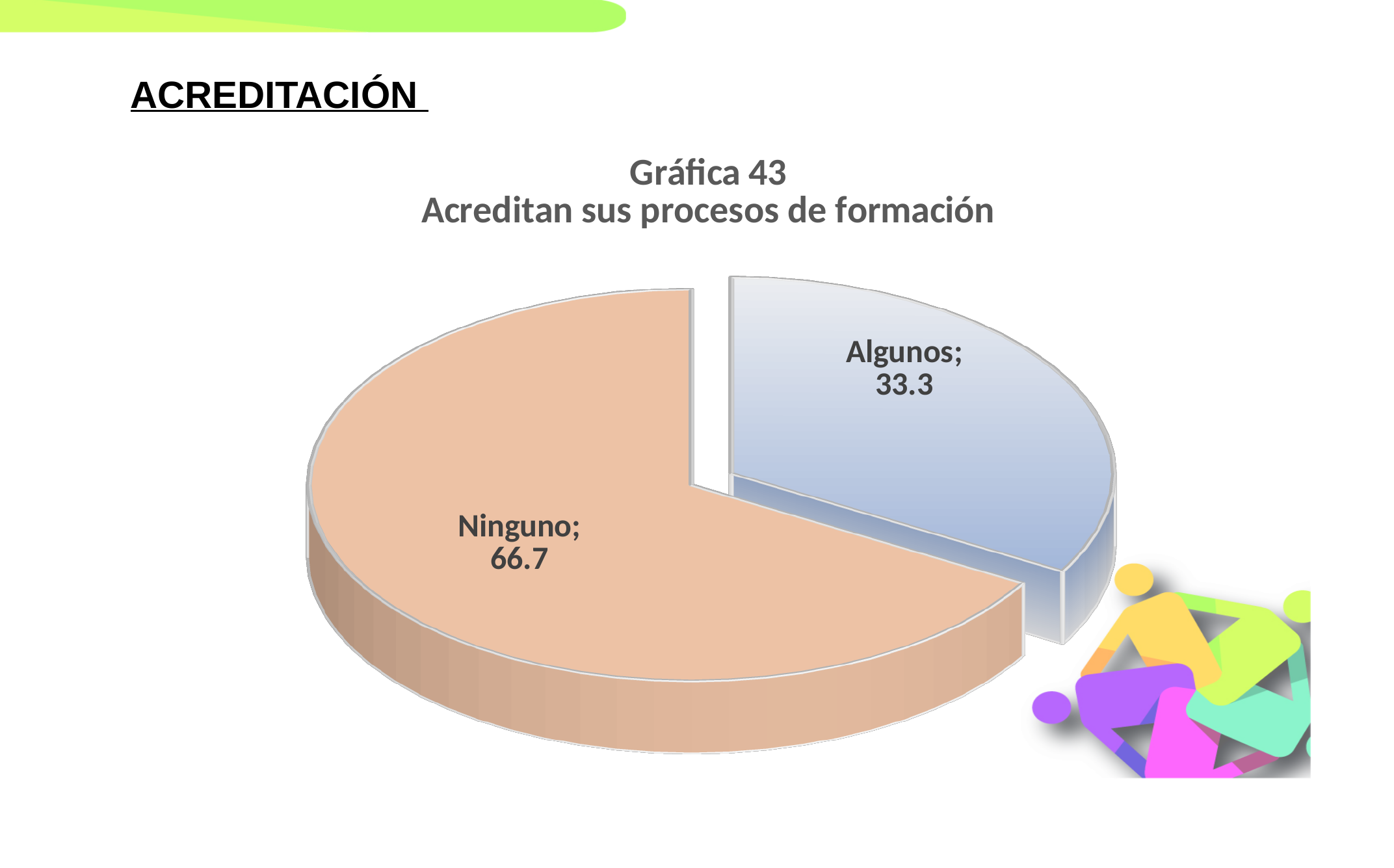
How many categories are shown in the pie chart? 2 What is the value for Ninguno? 66.7 What share of the pie does the Ninguno slice represent? 66.7 What is the value for Algunos? 33.3 What share of the pie does the Algunos slice represent? 33.3 What is the title of the chart? Gráfica 43 Acreditan sus procesos de formación What is the difference between the values for Ninguno and Algunos? 33.4 Which category has the smallest slice? Algunos Which category has the largest slice? Ninguno What kind of chart is shown on the slide? Pie chart Which is larger, the value for Ninguno or the value for Algunos? Ninguno What colour is the Algunos slice? Light blue